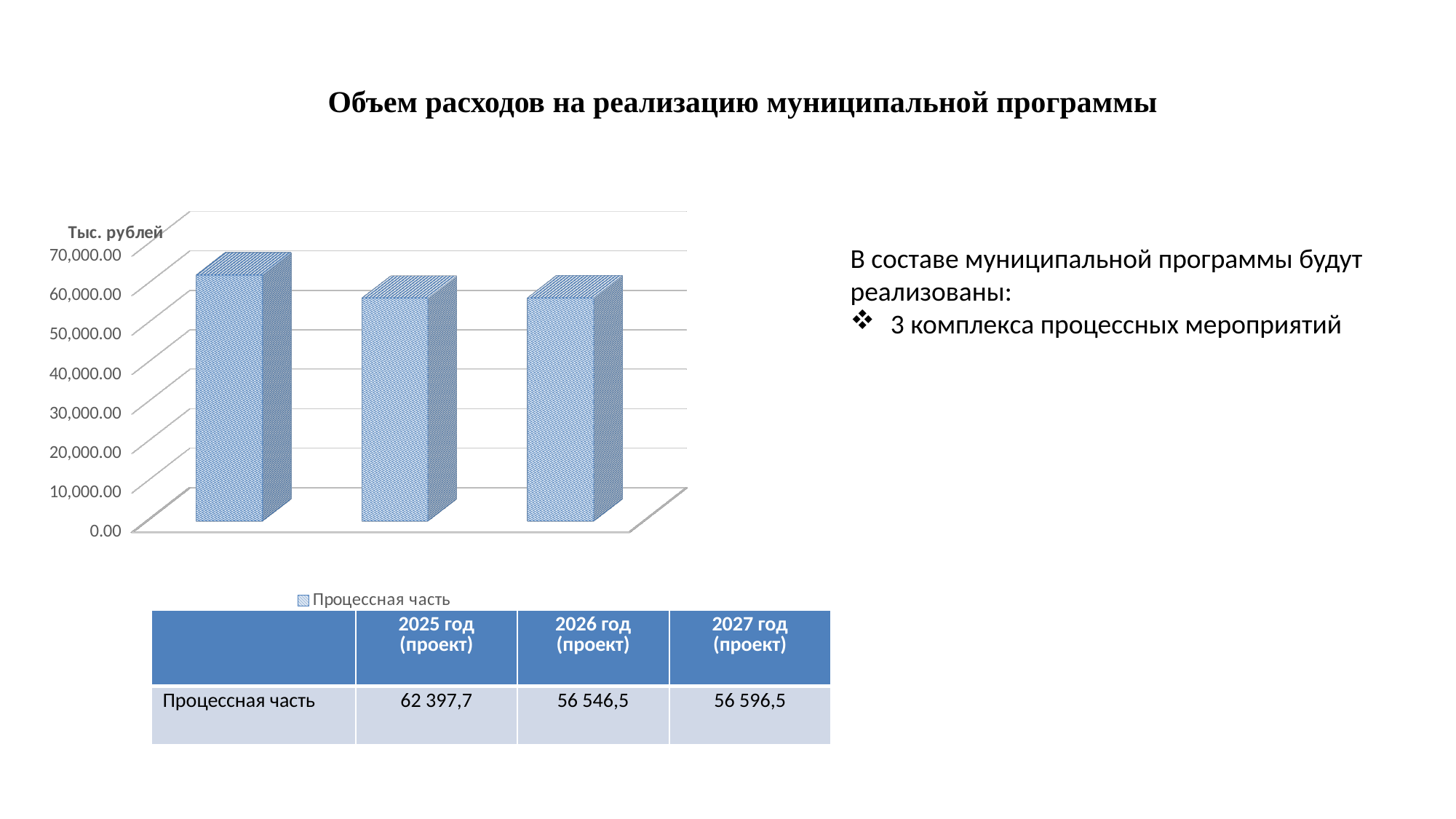
Is the value for 2025 год (проект) greater or less than 60,000.00? greater Which is larger, the value for 2025 год (проект) or for 2026 год (проект)? 2025 год (проект) Is the value for 2026 год (проект) greater or less than 60,000.00? less What kind of chart is shown on the slide? bar chart What is the value for 2027 год (проект) in the chart's data table? 56 596,5 What is the value for 2026 год (проект) in the chart's data table? 56 546,5 Which year has the highest value in the chart? 2025 год (проект) What is the value for 2025 год (проект) in the chart's data table? 62 397,7 What unit label is shown on the chart's vertical axis? Тыс. рублей What is the difference between the values for 2025 год (проект) and 2026 год (проект)? 5 851,2 How many bars are plotted in the chart? 3 How many series does the chart legend list? 1